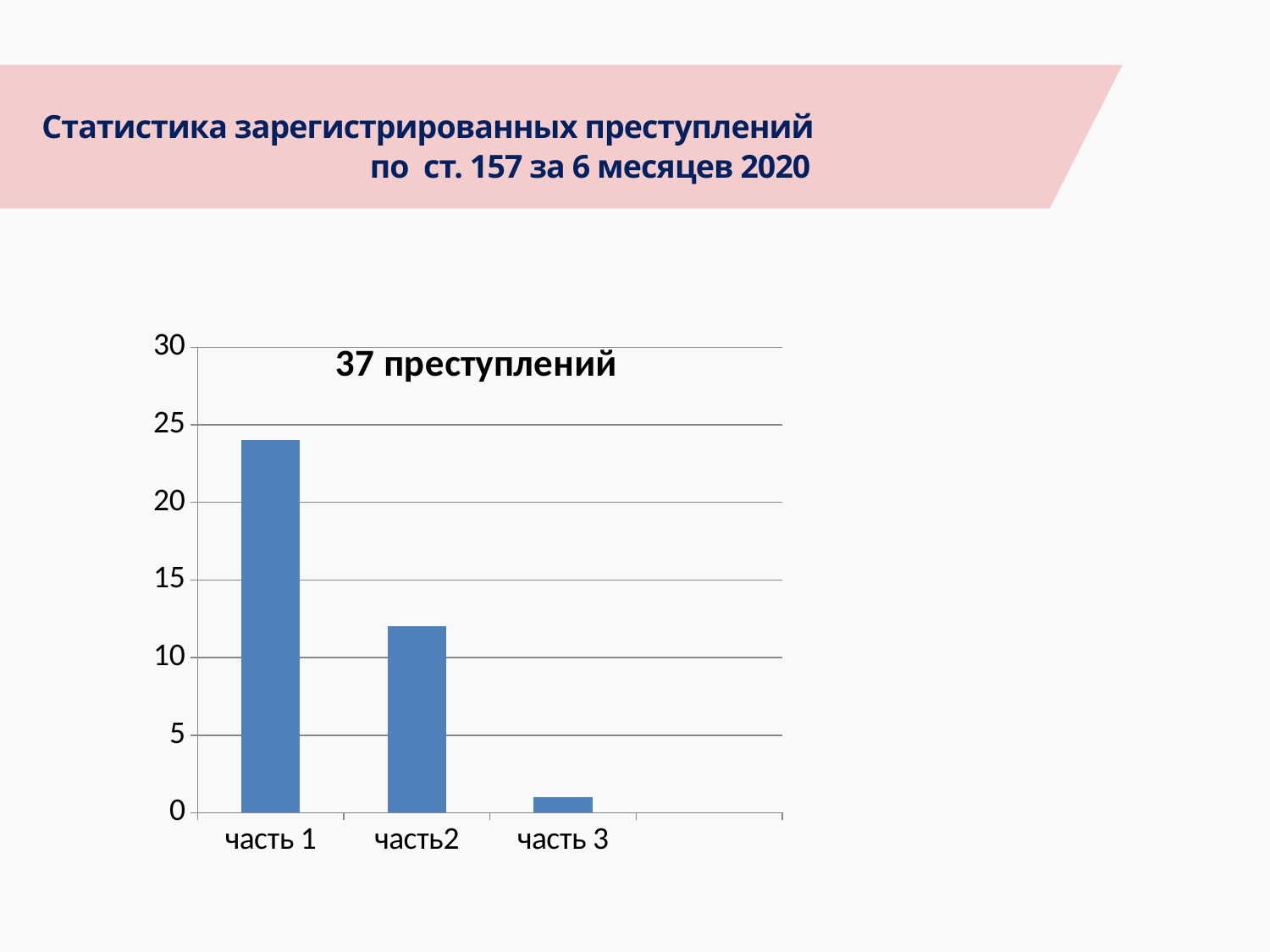
Is the value for часть 3 greater or less than 5? less Do the values rise or fall from часть 1 to часть 3 along the x axis? fall Which category has the lowest value? часть 3 Is the value for часть 1 greater or less than 20? greater Which is larger, the value for часть 1 or the value for часть2? часть 1 What is the title of the chart? 37 преступлений Is the value for часть2 greater or less than 15? less What type of chart is shown on the slide? bar chart How many categories are shown on the x axis of the chart? 3 Which is larger, the value for часть2 or the value for часть 3? часть2 Which category has the highest value? часть 1